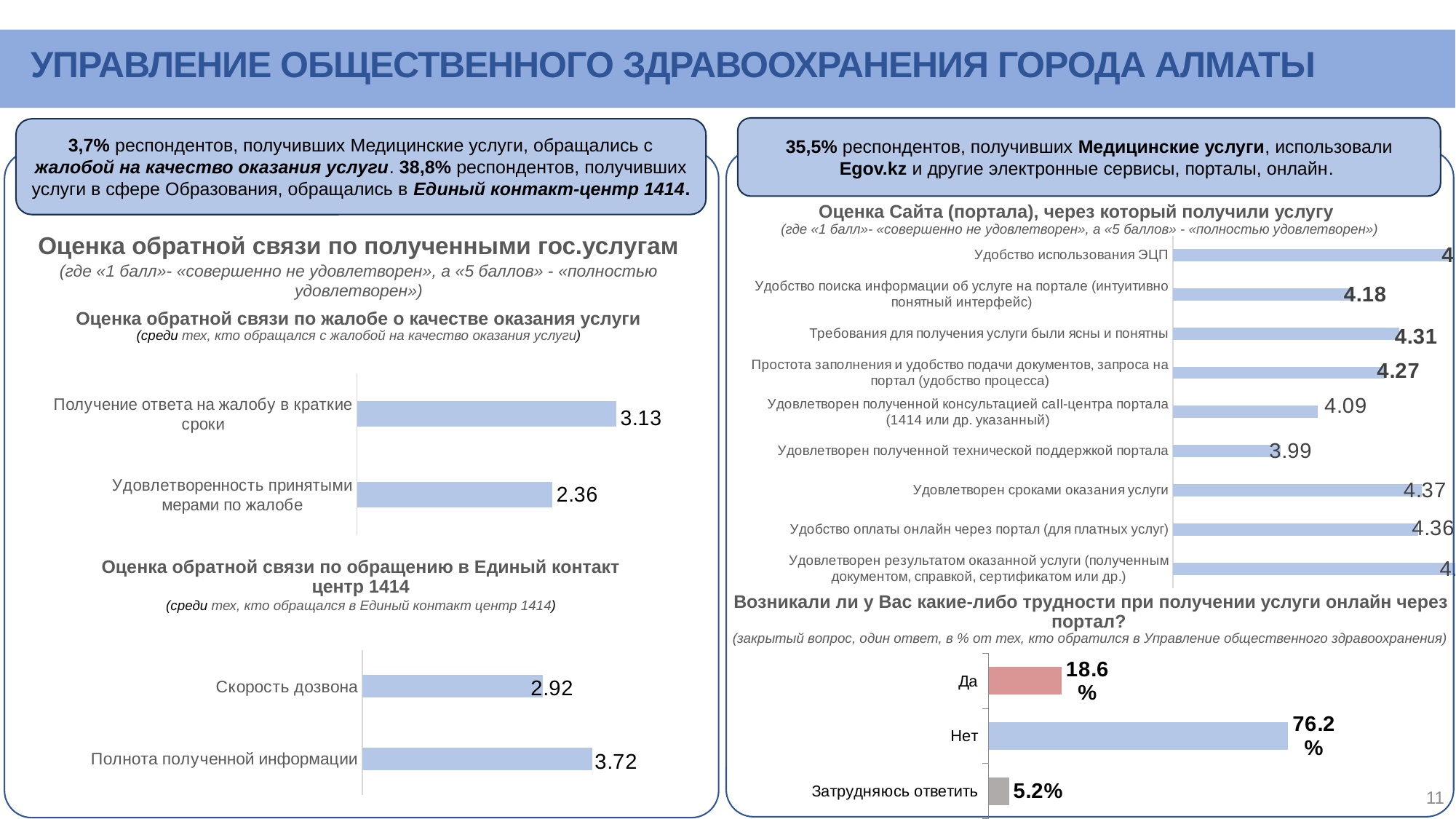
In the chart 'Оценка обратной связи по жалобе о качестве оказания услуги', what is the value for 'Удовлетворенность принятыми мерами по жалобе'? 2.36 In the chart 'Оценка Сайта (портала), через который получили услугу', which category has the lowest value? Удовлетворен полученной технической поддержкой портала In the chart 'Оценка обратной связи по обращению в Единый контакт центр 1414', what is the value for 'Скорость дозвона'? 2.92 In the chart 'Оценка обратной связи по жалобе о качестве оказания услуги', what is the difference between the two values? 0.77 In the chart 'Оценка Сайта (портала), через который получили услугу', how many categories are shown? 9 In the chart 'Оценка Сайта (портала), через который получили услугу', what is the value for 'Требования для получения услуги были ясны и понятны'? 4.31 In the chart 'Возникали ли у Вас какие-либо трудности при получении услуги онлайн через портал?', what is the value for 'Нет'? 76.2% In the chart 'Оценка Сайта (портала), через который получили услугу', what is the value for 'Удовлетворен полученной технической поддержкой портала'? 3.99 In the chart 'Оценка обратной связи по жалобе о качестве оказания услуги', what is the value for 'Получение ответа на жалобу в краткие сроки'? 3.13 What type of chart is 'Возникали ли у Вас какие-либо трудности при получении услуги онлайн через портал?'? Bar chart In the chart 'Возникали ли у Вас какие-либо трудности при получении услуги онлайн через портал?', what is the difference between 'Да' and 'Затрудняюсь ответить'? 13.4% In the chart 'Оценка обратной связи по обращению в Единый контакт центр 1414', which category has the higher value? Полнота полученной информации